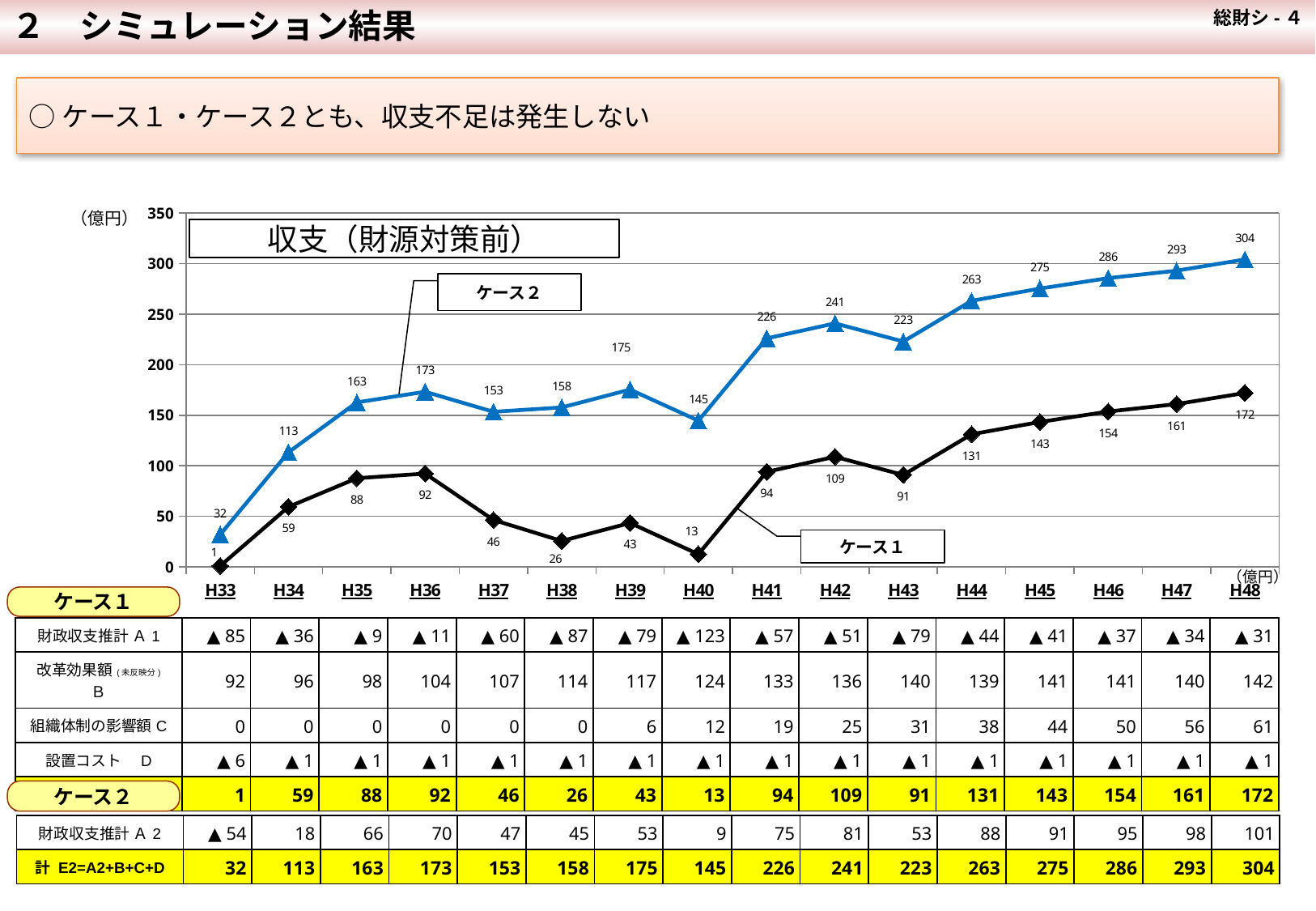
Is the value for ケース2 at H44 greater or less than 250? greater How many series are plotted in the chart? 2 What kind of chart is shown? line chart What is the title of the chart? 収支（財源対策前） At which year is ケース2 highest? H48 What is the difference between ケース2 and ケース1 at H40? 132 What is the value for ケース1 at H36? 92 What is the value for ケース1 at H48? 172 What is the value for ケース2 at H41? 226 At which year is ケース1 lowest? H33 How many years are plotted on the x axis? 16 Which is larger at H43: ケース2 or ケース1? ケース2